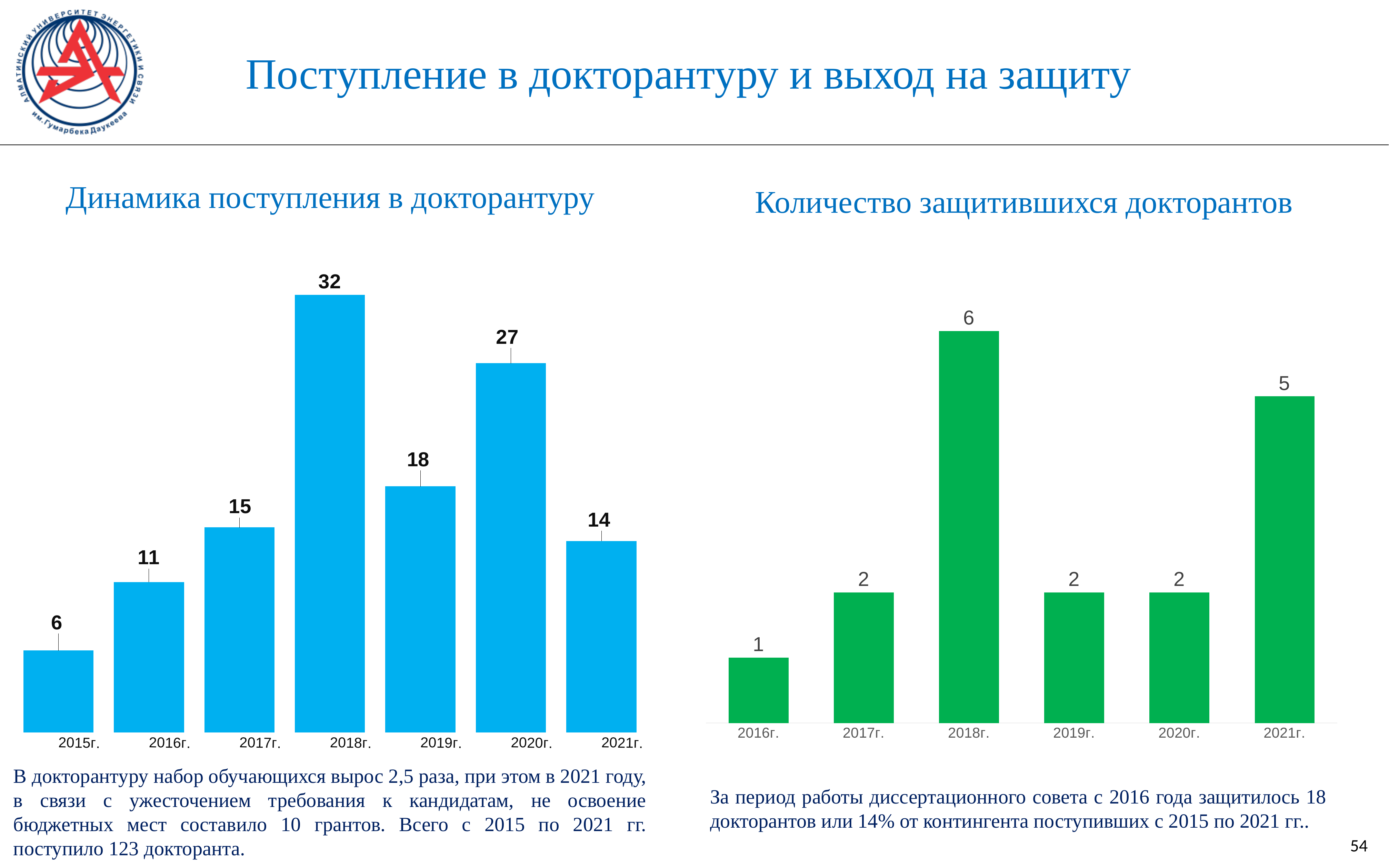
In the chart 'Динамика поступления в докторантуру', which year has the lowest value? 2015г. In the chart 'Количество защитившихся докторантов', what is the difference between the values for 2018г. and 2017г.? 4 In the chart 'Динамика поступления в докторантуру', what is the value for 2018г.? 32 What type of chart is 'Количество защитившихся докторантов'? Bar chart In the chart 'Динамика поступления в докторантуру', what is the difference between the values for 2020г. and 2021г.? 13 In the chart 'Динамика поступления в докторантуру', what is the value for 2015г.? 6 In the chart 'Количество защитившихся докторантов', how many years are shown on the x axis? 6 In the chart 'Количество защитившихся докторантов', which year has the highest value? 2018г. In the chart 'Динамика поступления в докторантуру', which is larger, the value for 2017г. or the value for 2019г.? 2019г. In the chart 'Количество защитившихся докторантов', what is the value for 2021г.? 5 In the chart 'Количество защитившихся докторантов', which year has the lowest value? 2016г. In the chart 'Динамика поступления в докторантуру', how many years are shown on the x axis? 7